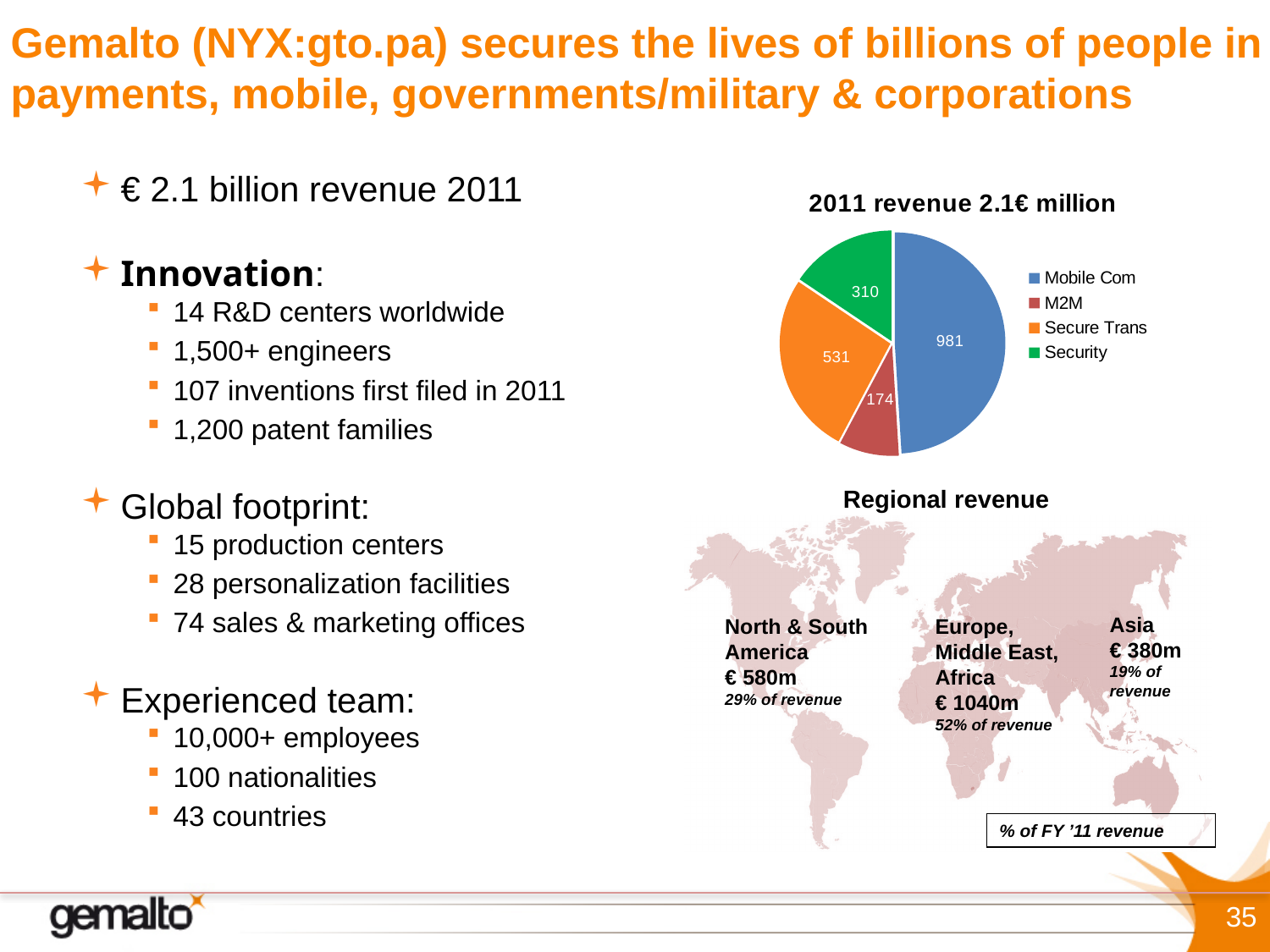
What kind of chart is the "2011 revenue 2.1€ million" chart? pie chart In the "2011 revenue 2.1€ million" pie chart, what colour is the Mobile Com segment? blue In the "2011 revenue 2.1€ million" pie chart, what is the value for Secure Trans? 531 In the "2011 revenue 2.1€ million" pie chart, what is the value for Security? 310 In the "2011 revenue 2.1€ million" pie chart, what is the difference between the Secure Trans and Security values? 221 In the "2011 revenue 2.1€ million" pie chart, which segment has the lowest value? M2M In the "2011 revenue 2.1€ million" pie chart, what is the difference between the Mobile Com and M2M values? 807 How many segments does the "2011 revenue 2.1€ million" pie chart have? 4 In the "2011 revenue 2.1€ million" pie chart, what is the value for Mobile Com? 981 In the "2011 revenue 2.1€ million" pie chart, which segment has the highest value? Mobile Com In the "2011 revenue 2.1€ million" pie chart, which is larger, Secure Trans or Security? Secure Trans In the "2011 revenue 2.1€ million" pie chart, what is the value for M2M? 174